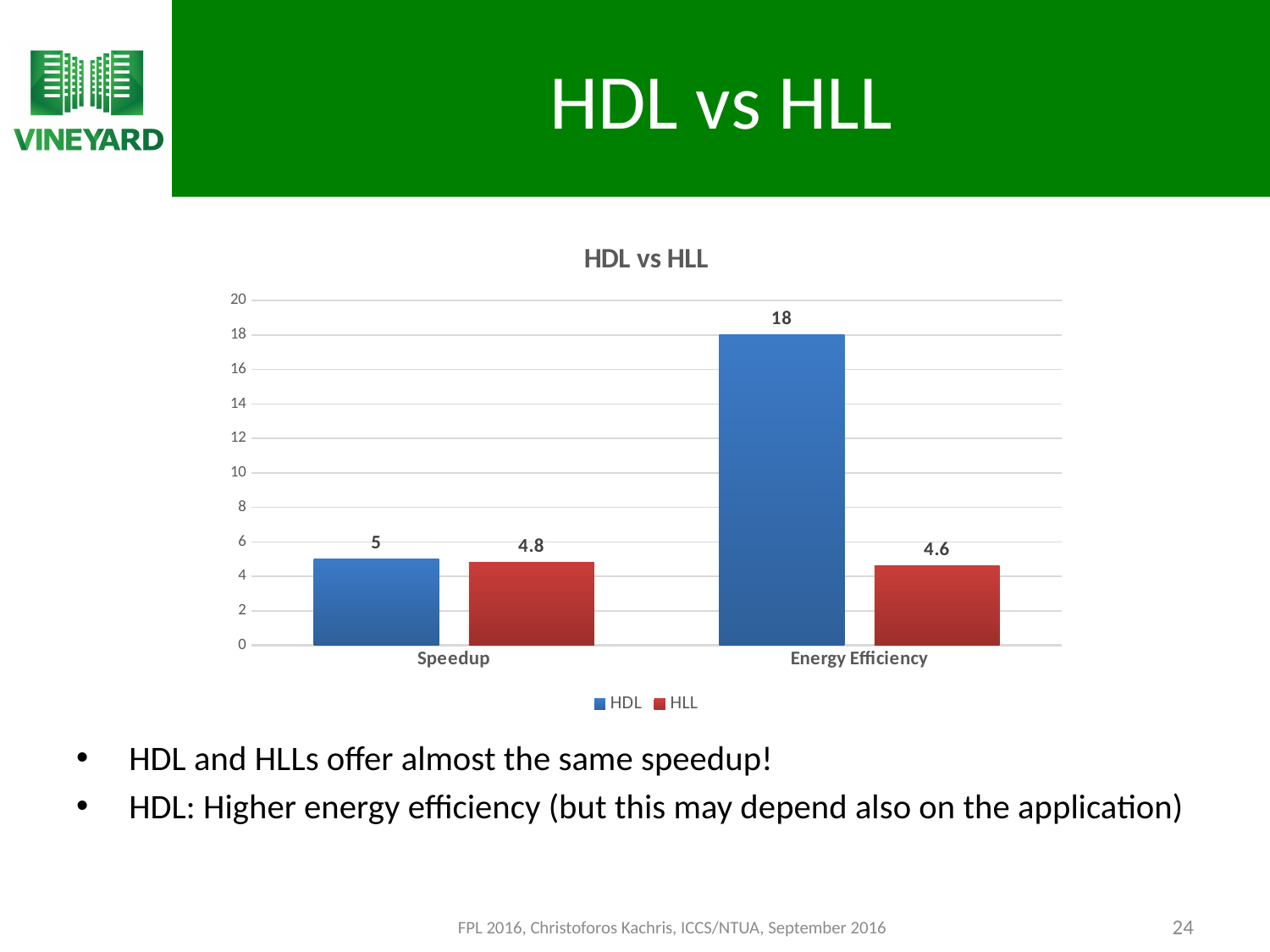
Which bar has the highest value in the chart? HDL, Energy Efficiency What is the HLL value for Speedup? 4.8 What kind of chart is shown on the slide? bar chart How many categories are shown on the x axis? 2 Which is larger for Energy Efficiency, HDL or HLL? HDL What is the difference between the HDL and HLL values for Energy Efficiency? 13.4 What is the HLL value for Energy Efficiency? 4.6 What is the HDL value for Speedup? 5 How many series does the legend list? 2 Is the HDL value for Energy Efficiency greater or less than 10? greater What is the HDL value for Energy Efficiency? 18 Which series has the lowest value for Energy Efficiency? HLL